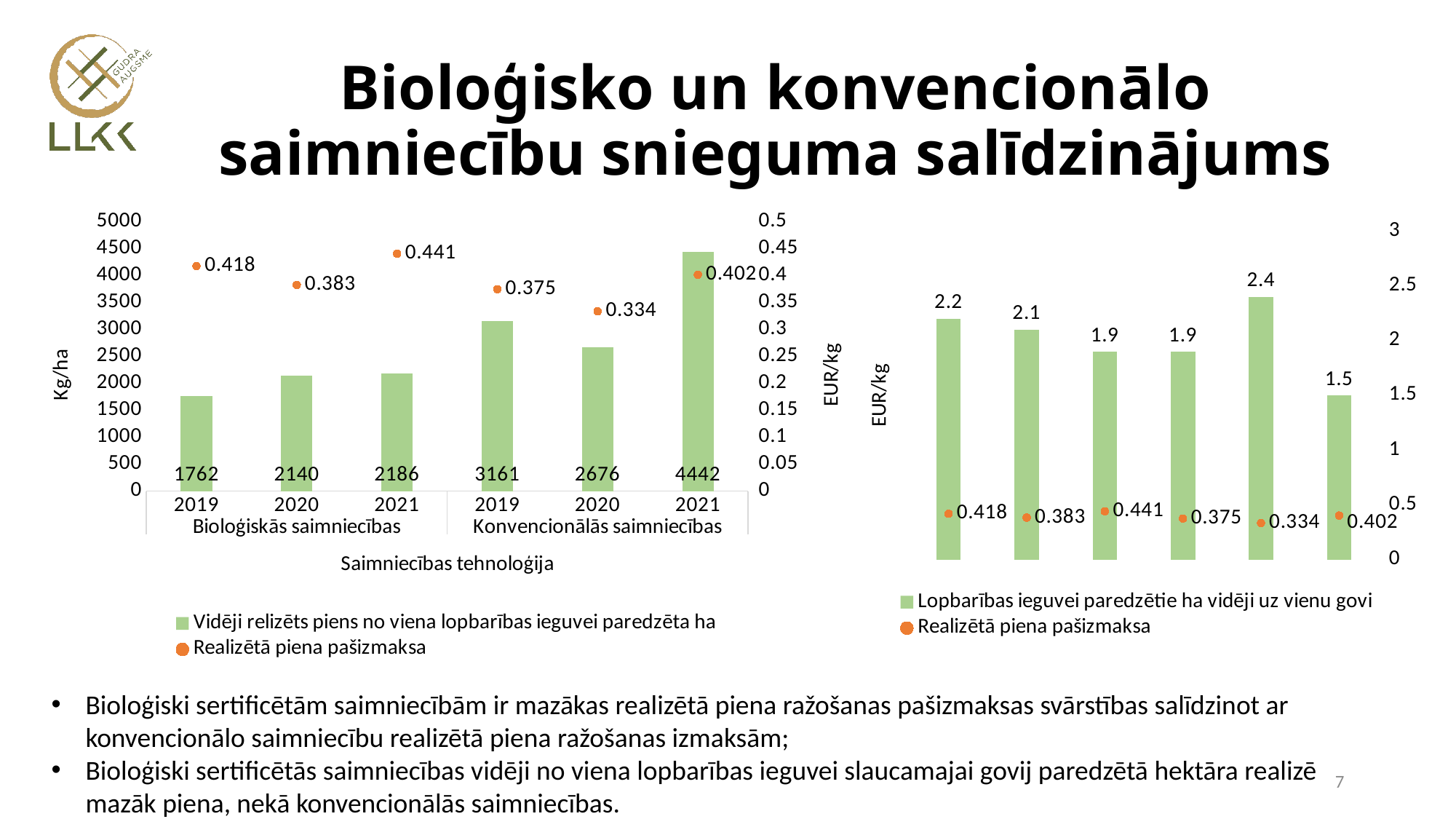
In the left chart, what is the value of the bar for 2019 under Bioloģiskās saimniecības? 1762 In the left chart, what is the Realizētā piena pašizmaksa value for 2020 under Bioloģiskās saimniecības? 0.383 In the left chart, what is the difference between the bar values for 2021 and 2019 under Konvencionālās saimniecības? 1281 In the right chart, what is the highest bar value? 2.4 How many bars are plotted in the left chart? 6 In the left chart, which year and farm type has the lowest Realizētā piena pašizmaksa value? 2020, Konvencionālās saimniecības In the left chart, what is the value of the bar for 2021 under Konvencionālās saimniecības? 4442 In the left chart, which year and farm type has the highest bar value? 2021, Konvencionālās saimniecības How many series does the legend of the right chart list? 2 In the left chart, which is larger: the bar value for 2020 under Bioloģiskās saimniecības or for 2020 under Konvencionālās saimniecības? 2020 under Konvencionālās saimniecības In the right chart, what is the lowest bar value? 1.5 In the left chart, do the bar values rise or fall from 2019 to 2021 under Bioloģiskās saimniecības? rise